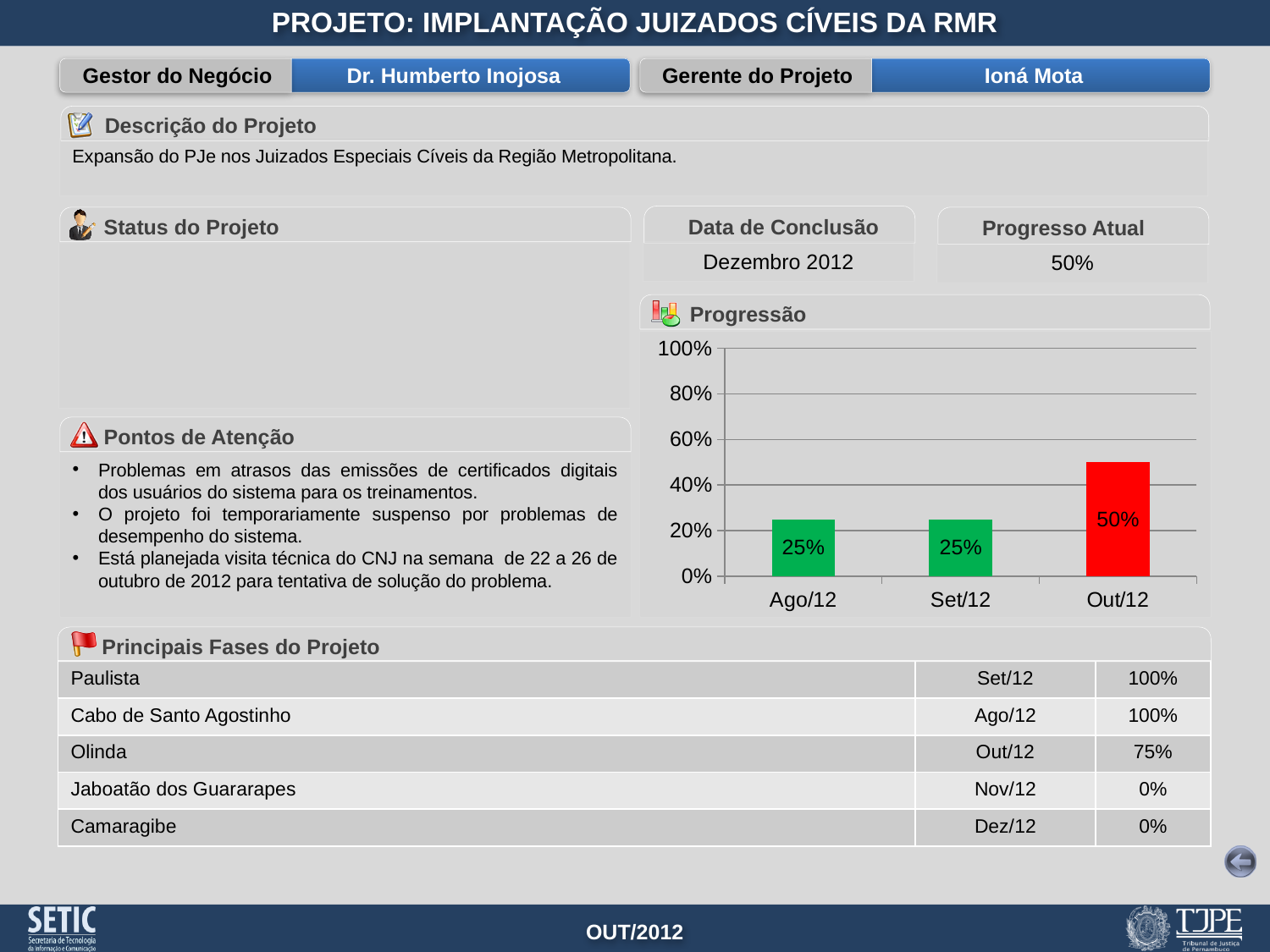
Which month has the highest value in the Progressão chart? Out/12 Is the value for Ago/12 in the Progressão chart greater or less than 40%? less Do the values in the Progressão chart rise or fall from Set/12 to Out/12? rise What colour is the Out/12 bar in the Progressão chart? red Which is larger in the Progressão chart, the value for Ago/12 or the value for Out/12? Out/12 What kind of chart is the Progressão chart? bar chart What is the value for Out/12 in the Progressão chart? 50% What is the value for Ago/12 in the Progressão chart? 25% What is the value for Set/12 in the Progressão chart? 25% Is the value for Out/12 in the Progressão chart greater or less than 40%? greater What is the difference between the values for Out/12 and Set/12 in the Progressão chart? 25% How many months are shown on the x axis of the Progressão chart? 3